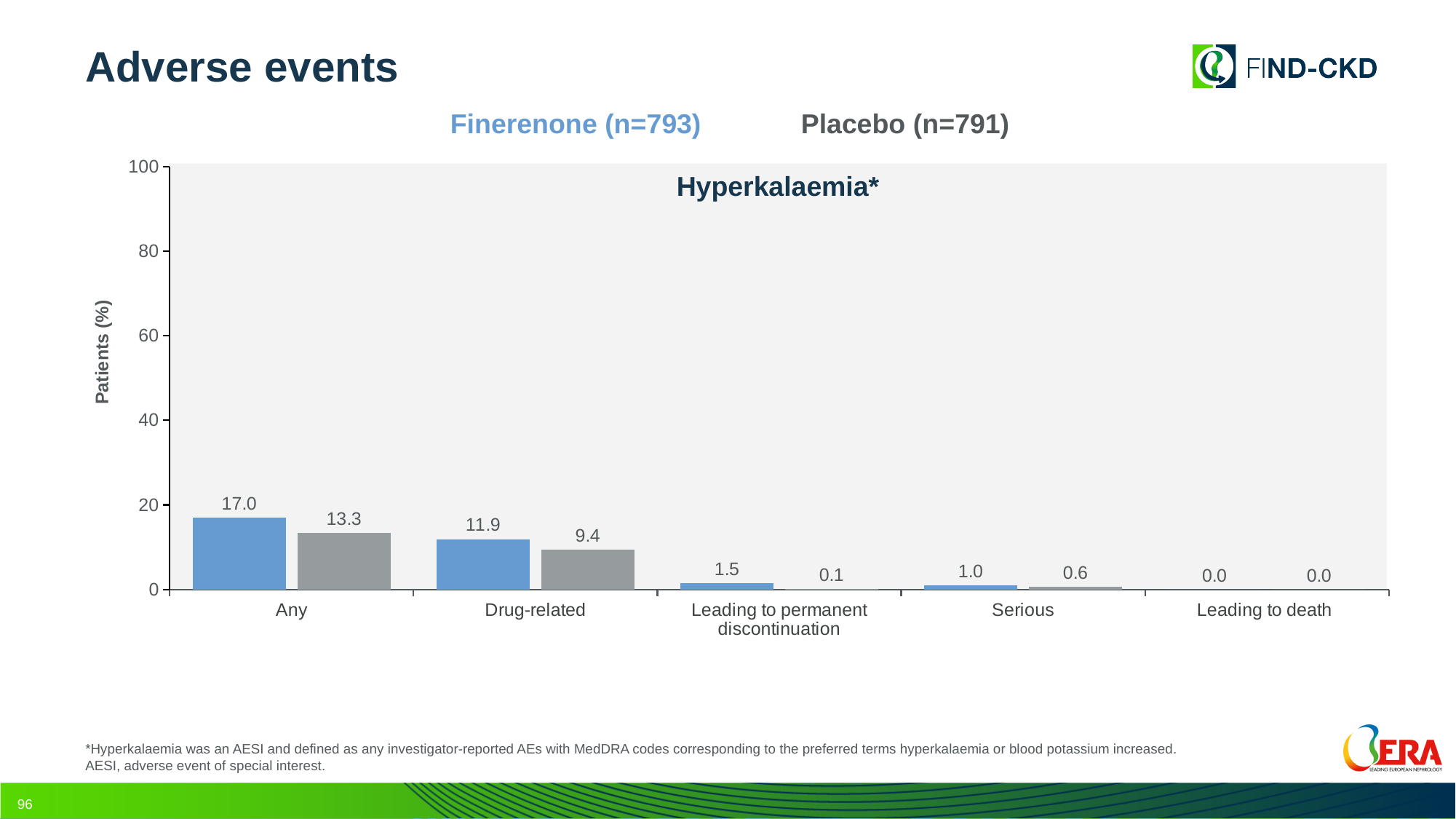
What is the title shown inside the chart area? Hyperkalaemia* What is the Placebo value for Leading to permanent discontinuation? 0.1 Which is larger for the Drug-related category, Finerenone or Placebo? Finerenone What kind of chart is shown on the slide? Bar chart What is the Finerenone value for the Serious category? 1.0 What is the Placebo value for the Drug-related category? 9.4 Which category has the lowest Placebo value? Leading to death What is the Finerenone value for the Any category? 17.0 How many categories are shown on the x axis? 5 Which category has the highest Finerenone value? Any How many series does the chart show? 2 What is the difference between the Finerenone and Placebo values for the Any category? 3.7